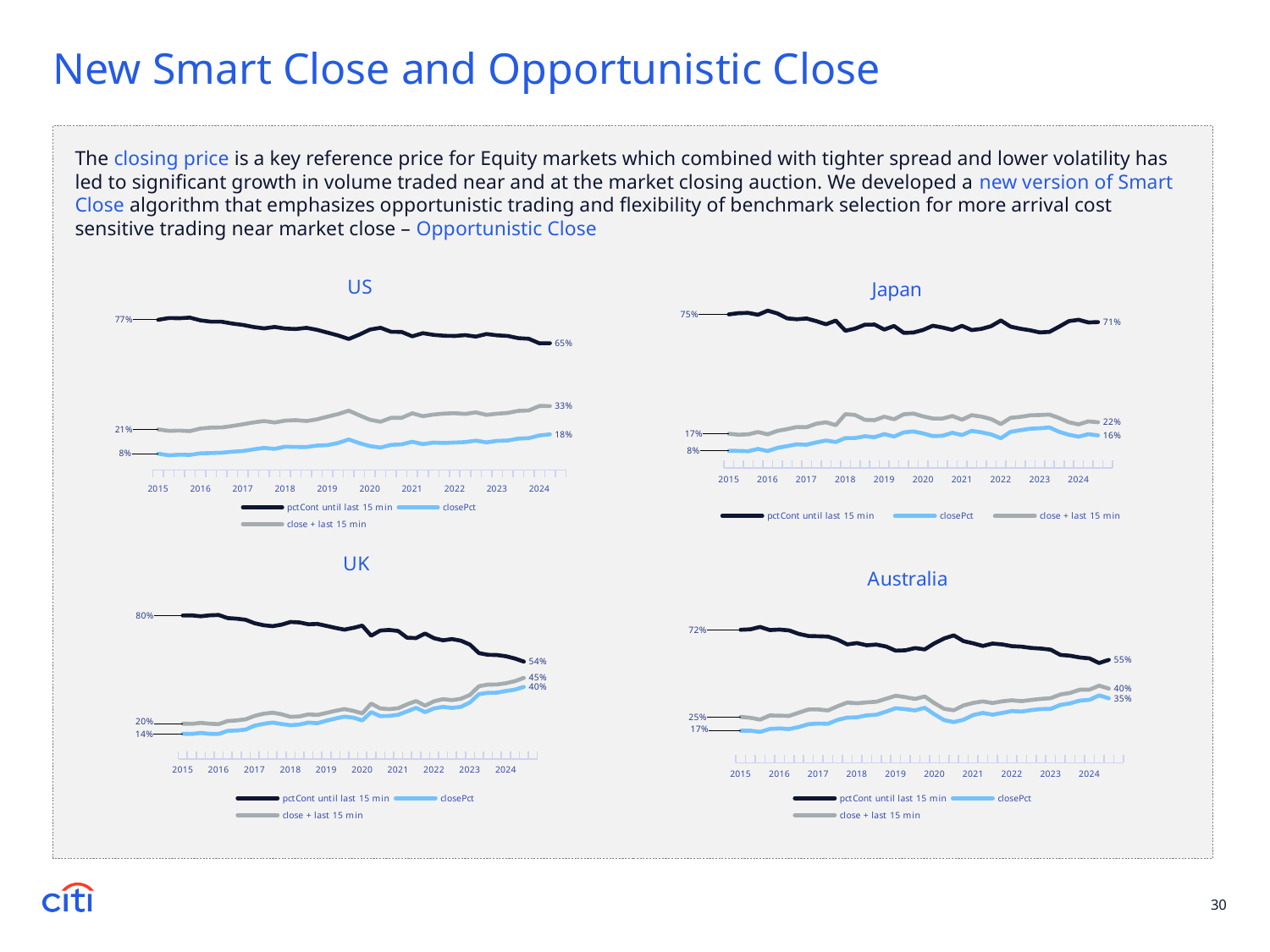
On the US chart, what is the final (2024) value of the pctCont until last 15 min series? 65% On the Japan chart, does the pctCont until last 15 min series rise or fall from 2015 to 2024? fall On the US chart, what is the starting (2015) value of the closePct series? 8% On the Japan chart, what is the final value of the close + last 15 min series? 22% On the US chart, what is the difference between the final values of the close + last 15 min series and the closePct series? 15 percentage points On the Australia chart, what is the final value of the closePct series? 35% On the UK chart, which series has the higher final value: closePct or close + last 15 min? close + last 15 min How many series does the legend of the Australia chart list? 3 What type of chart is used for the US panel? line chart On the UK chart, by how many percentage points did the pctCont until last 15 min series fall from its starting value to its final value? 26 percentage points On the UK chart, what is the starting value of the pctCont until last 15 min series? 80% On the Australia chart, does the close + last 15 min series rise or fall from 2015 to 2024? rise